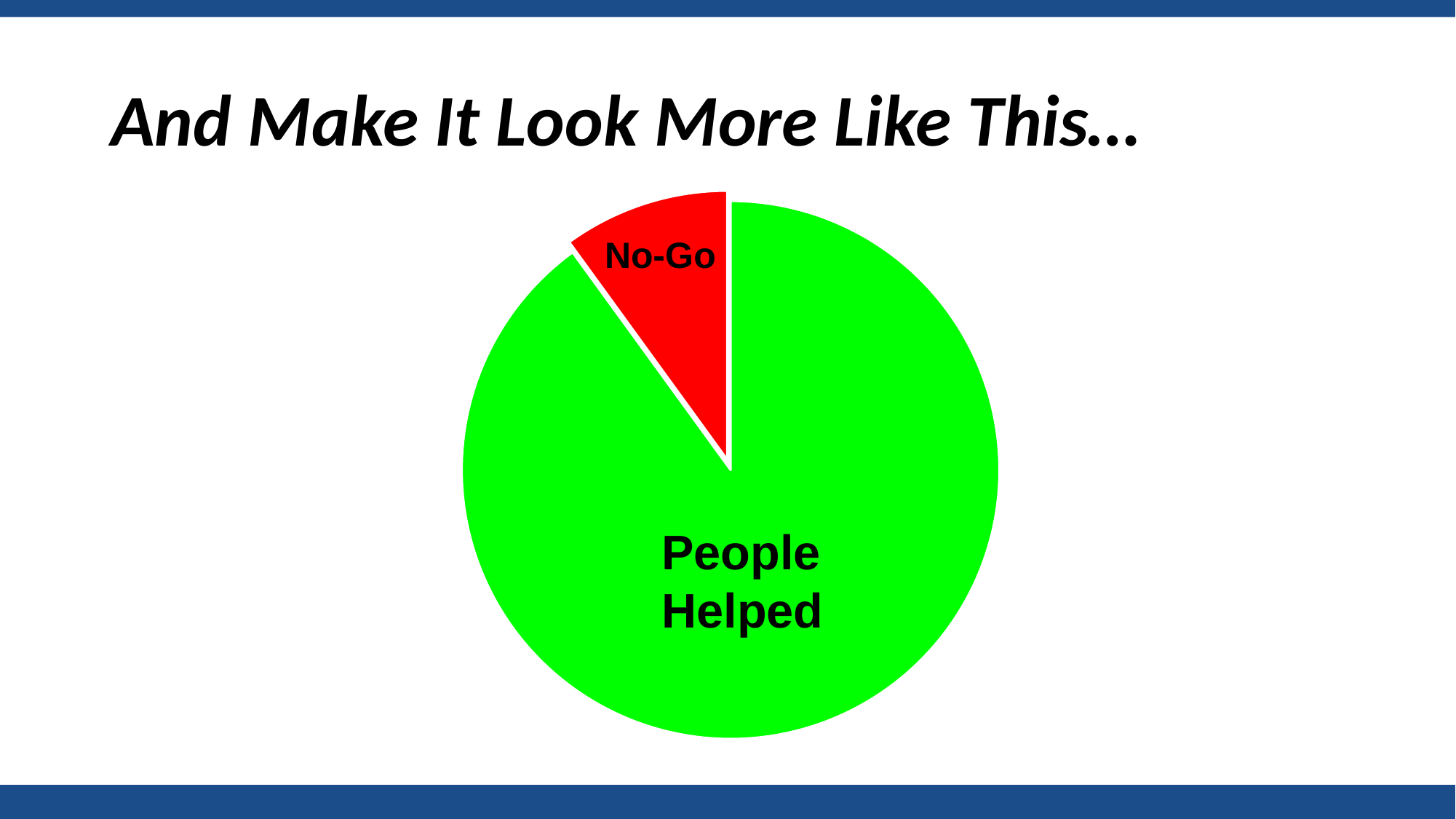
Which slice is larger, No-Go or People Helped? People Helped What colour is the People Helped slice? green What colour is the No-Go slice? red Which slice of the pie chart is the smallest? No-Go Which slice of the pie chart is the largest? People Helped What kind of chart is shown on the slide? pie chart How many slices does the pie chart have? 2